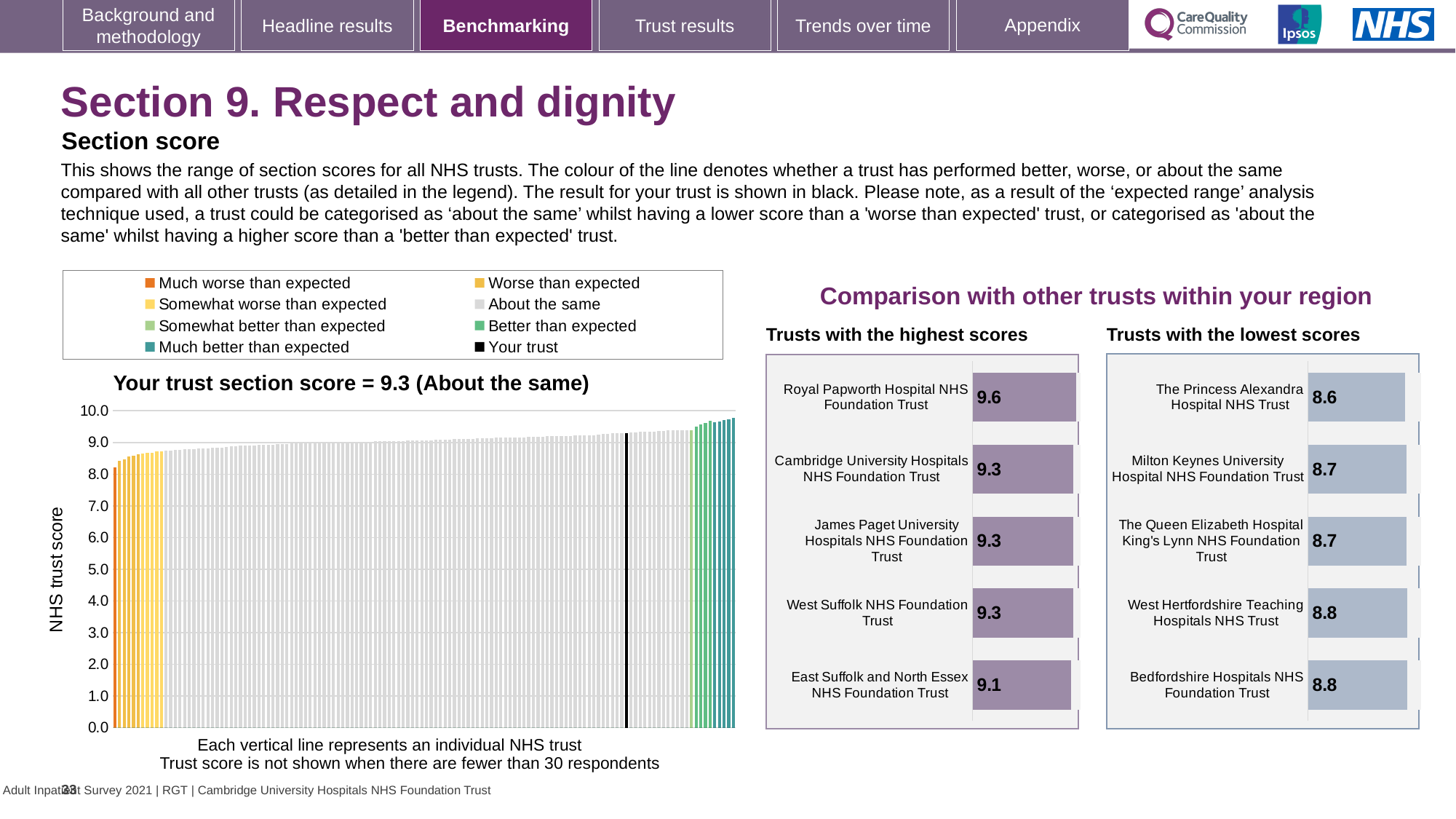
In the 'Trusts with the highest scores' chart, how many trusts are shown? 5 In the 'Trusts with the highest scores' chart, what is the difference between the scores of Royal Papworth Hospital NHS Foundation Trust and East Suffolk and North Essex NHS Foundation Trust? 0.5 How many entries does the legend above the 'Your trust section score' chart list? 8 What kind of chart is the 'Your trust section score' chart? bar chart In the 'Trusts with the highest scores' chart, what is the score for Royal Papworth Hospital NHS Foundation Trust? 9.6 In the 'Trusts with the highest scores' chart, which trust has the highest score? Royal Papworth Hospital NHS Foundation Trust In the 'Trusts with the lowest scores' chart, which has the larger score: Bedfordshire Hospitals NHS Foundation Trust or Milton Keynes University Hospital NHS Foundation Trust? Bedfordshire Hospitals NHS Foundation Trust In the 'Trusts with the lowest scores' chart, which trust has the lowest score? The Princess Alexandra Hospital NHS Trust In the 'Your trust section score' chart, is the value for your trust greater or less than 9.0? greater In the 'Trusts with the lowest scores' chart, what is the score for The Princess Alexandra Hospital NHS Trust? 8.6 In the 'Your trust section score' chart, do the values rise or fall from left to right along the x axis? rise In the 'Your trust section score' chart, what is the section score for your trust? 9.3